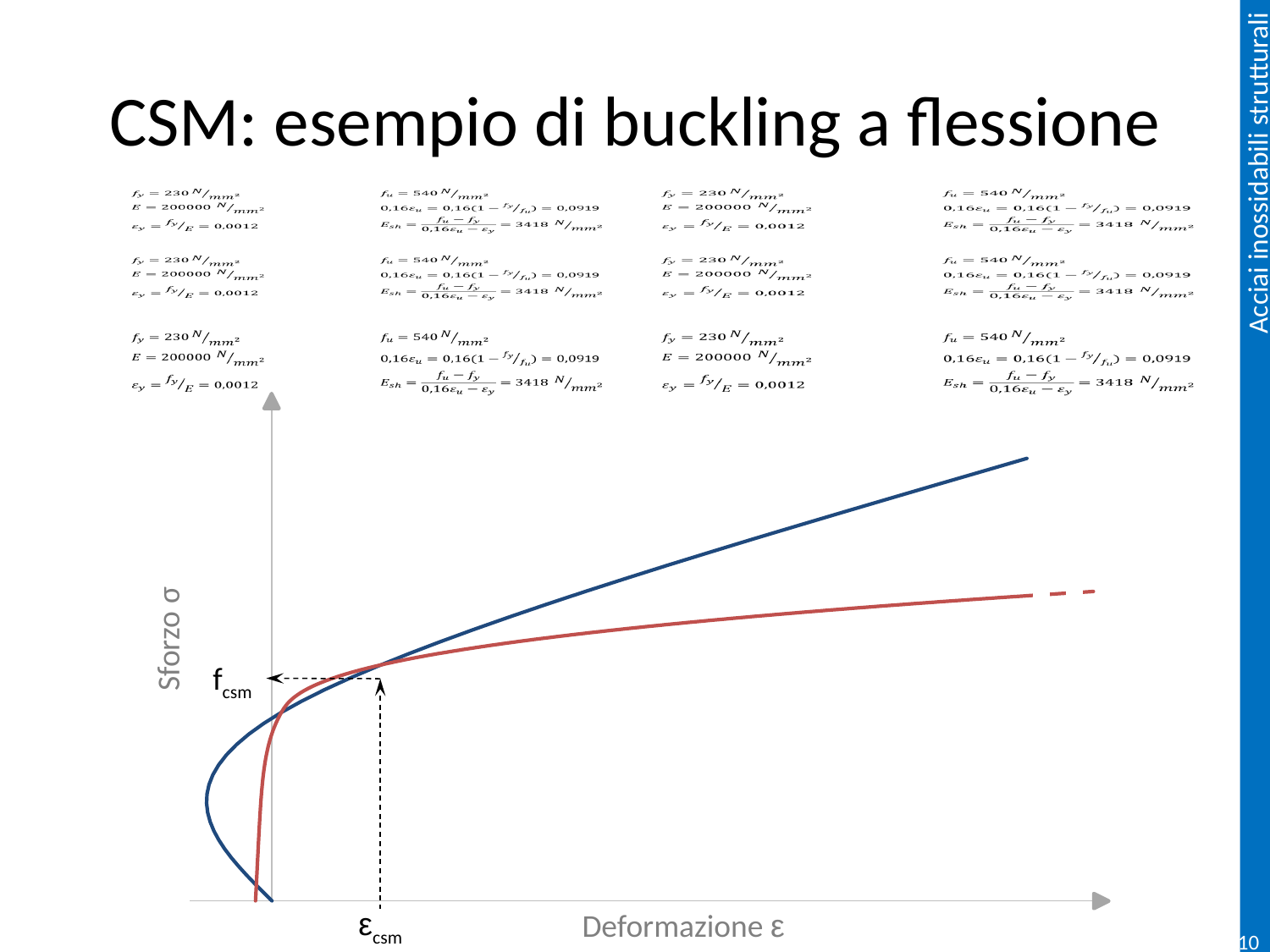
What kind of chart is shown on the slide? line chart How many curves are plotted on the chart? 2 What value is marked on the vertical axis by the dashed horizontal line? f_csm What is the label of the vertical axis of the chart? Sforzo σ At the right end of the chart, which curve reaches the higher stress value, the blue one or the red one? the blue one What value is marked on the horizontal axis by the dashed vertical line? ε_csm What is the label of the horizontal axis of the chart? Deformazione ε Does the red curve rise or fall as the strain (Deformazione ε) increases to the right? rise Which curve is drawn partly as a dashed line at its right end, the blue one or the red one? the red one